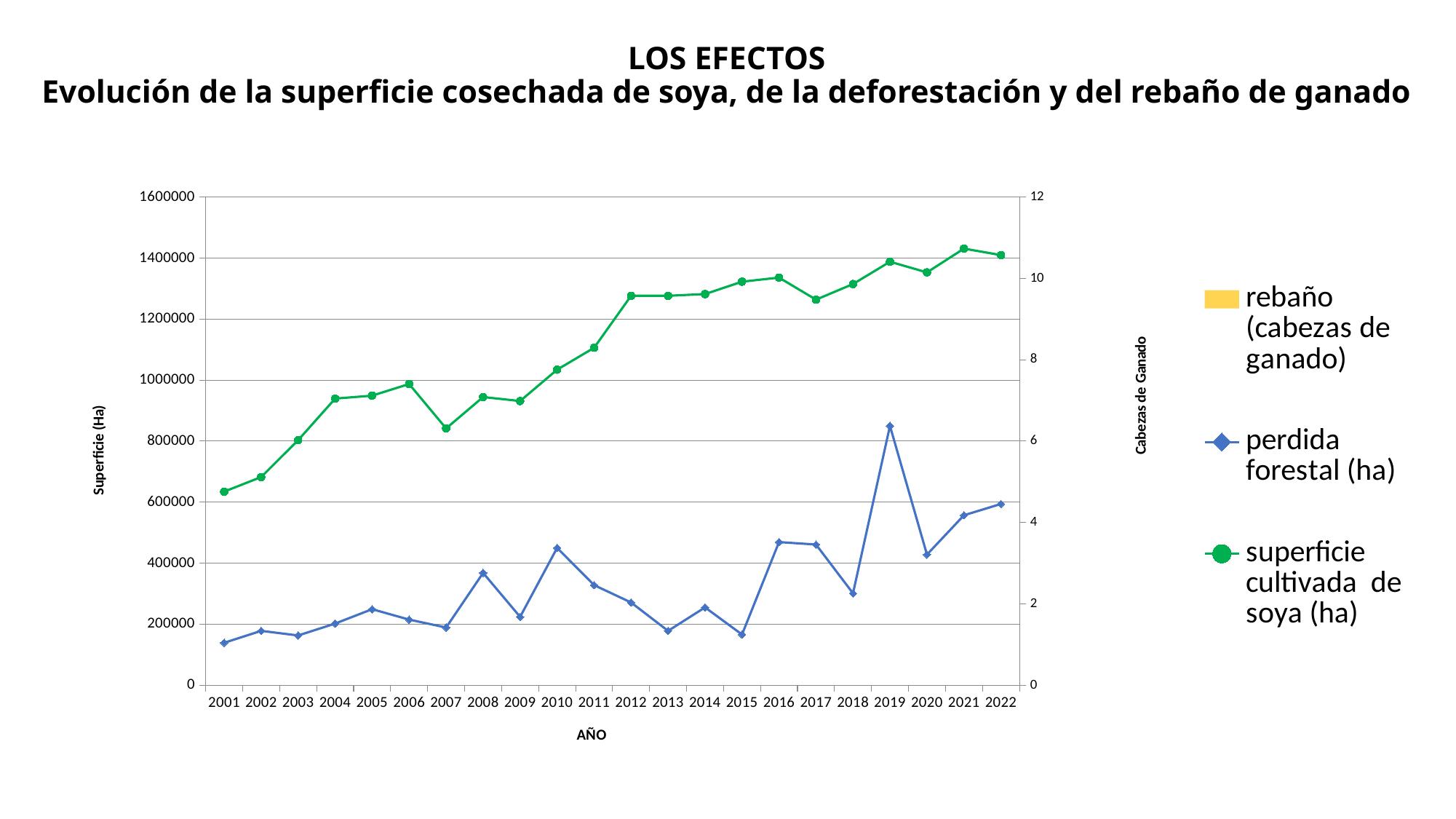
Is the value for perdida forestal (ha) in 2019 greater or less than 800000? greater In which year is the value for perdida forestal (ha) highest? 2019 What is the title of the left vertical axis? Superficie (Ha) In which year is the value for superficie cultivada de soya (ha) lowest? 2001 Which year has the larger value for superficie cultivada de soya (ha), 2006 or 2007? 2006 Does the superficie cultivada de soya (ha) series generally rise or fall from 2001 to 2022? rise Is the value for superficie cultivada de soya (ha) in 2007 greater or less than 1000000? less Is the value for perdida forestal (ha) in 2015 greater or less than 200000? less How many years are shown on the x axis? 22 What kind of chart is shown on the slide? line chart How many series does the legend list? 3